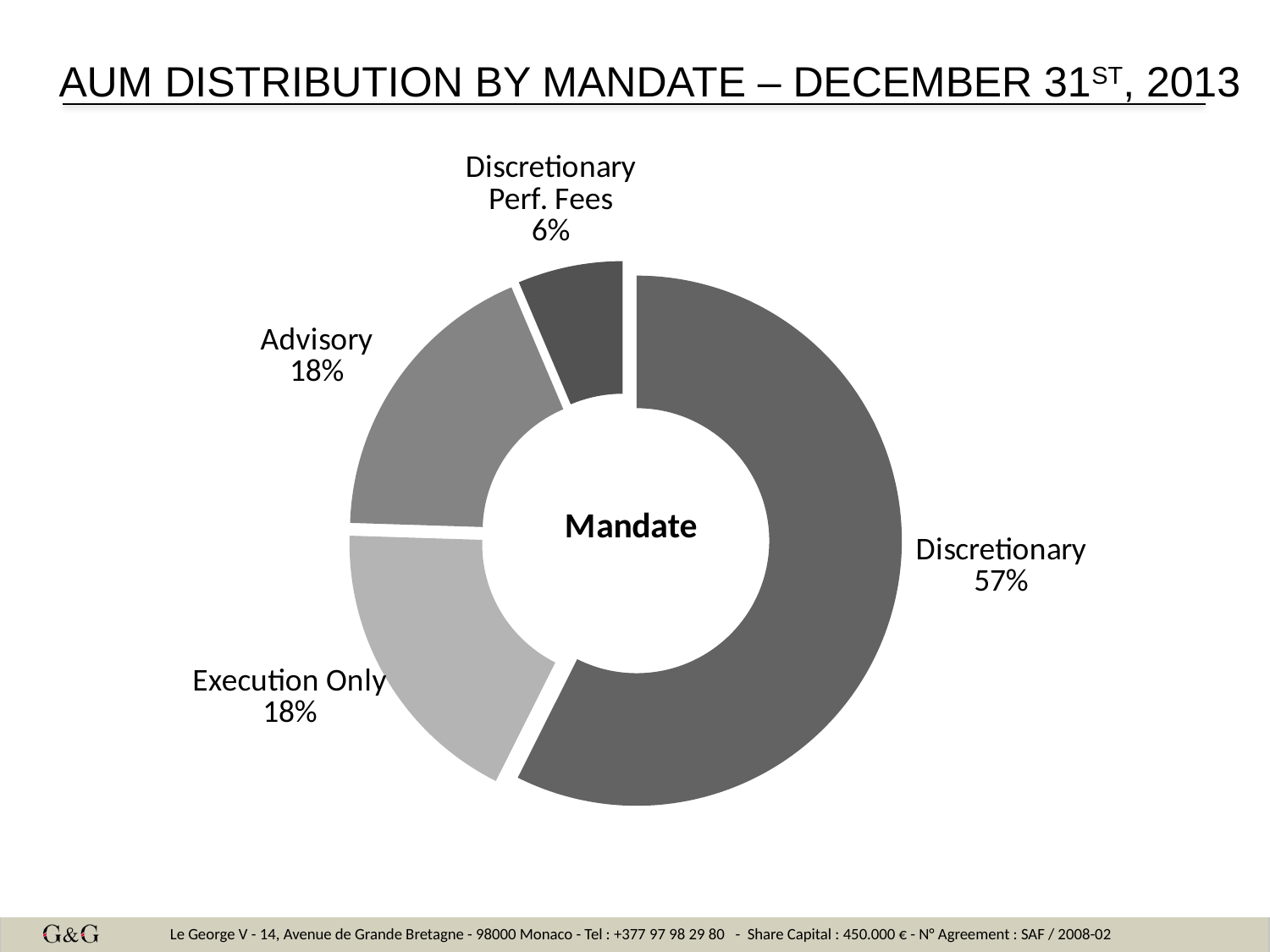
What word is printed in the centre of the doughnut chart? Mandate What is the title of the slide? AUM DISTRIBUTION BY MANDATE – DECEMBER 31ST, 2013 What is the difference in percentage points between the Discretionary and Advisory shares? 39 What share of AUM is in the Execution Only mandate? 18% What share of AUM is in the Discretionary mandate? 57% Which mandate has the smallest share of AUM? Discretionary Perf. Fees Which is larger, the Advisory share or the Discretionary Perf. Fees share? Advisory Which mandate has the largest share of AUM? Discretionary What share of AUM is in the Advisory mandate? 18% What share of AUM is in the Discretionary Perf. Fees mandate? 6% How many mandate categories are shown in the chart? 4 What kind of chart is shown on the slide? Doughnut chart